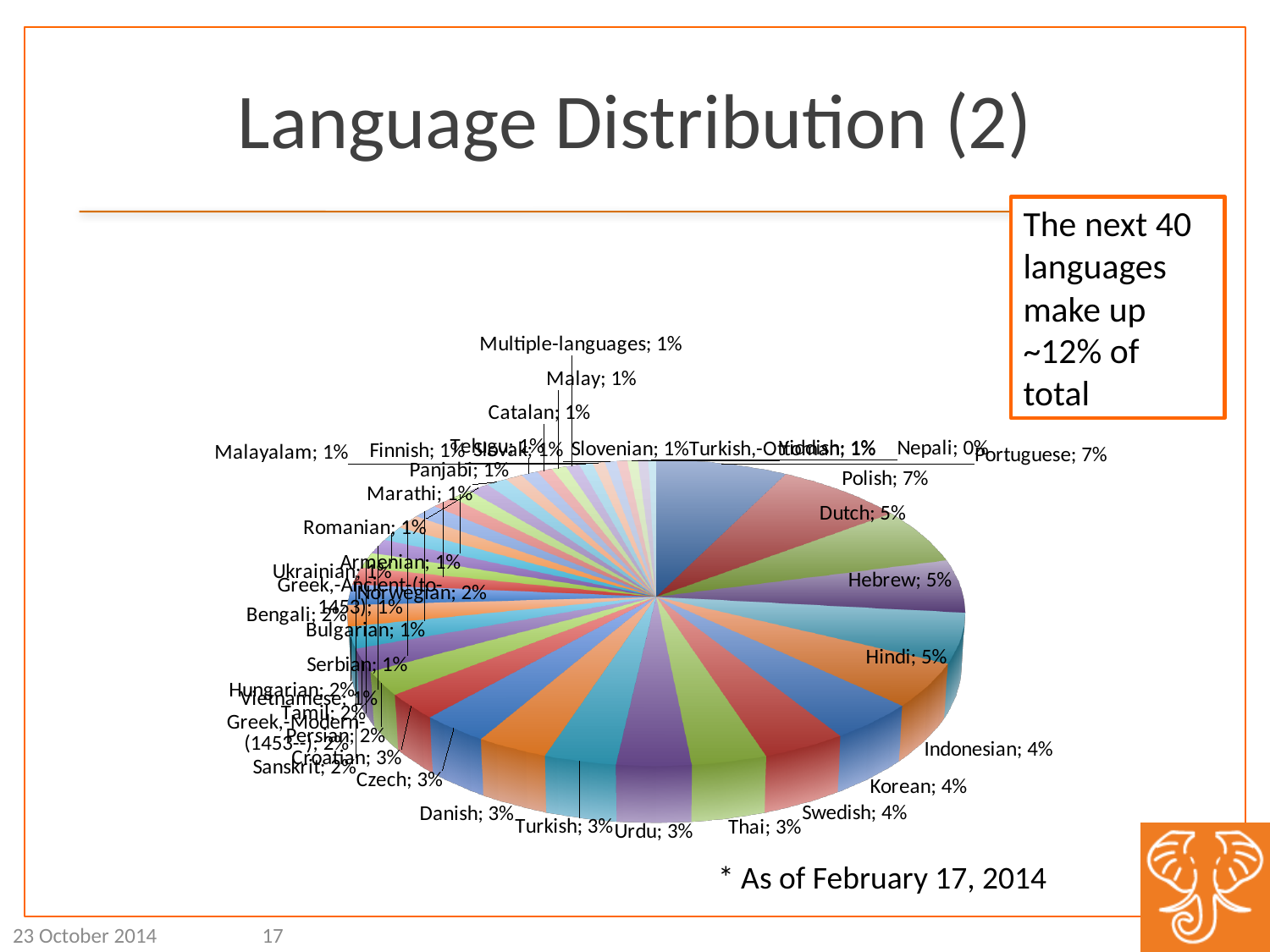
What is the value shown for Thai? 3% What is the value shown for Dutch? 5% What is the value shown for Polish? 7% What is the value shown for Hindi? 5% Which is larger, the share for Portuguese or the share for Dutch? Portuguese What is the value shown for Indonesian? 4% According to the text box on the slide, roughly what share of the total do the next 40 languages make up? ~12% What is the value shown for Sanskrit? 2% What share of the pie does Portuguese account for? 7% Which language has the smallest labelled share in the pie chart? Nepali What is the difference between the share for Polish and the share for Korean? 3% What kind of chart is shown on the slide? pie chart